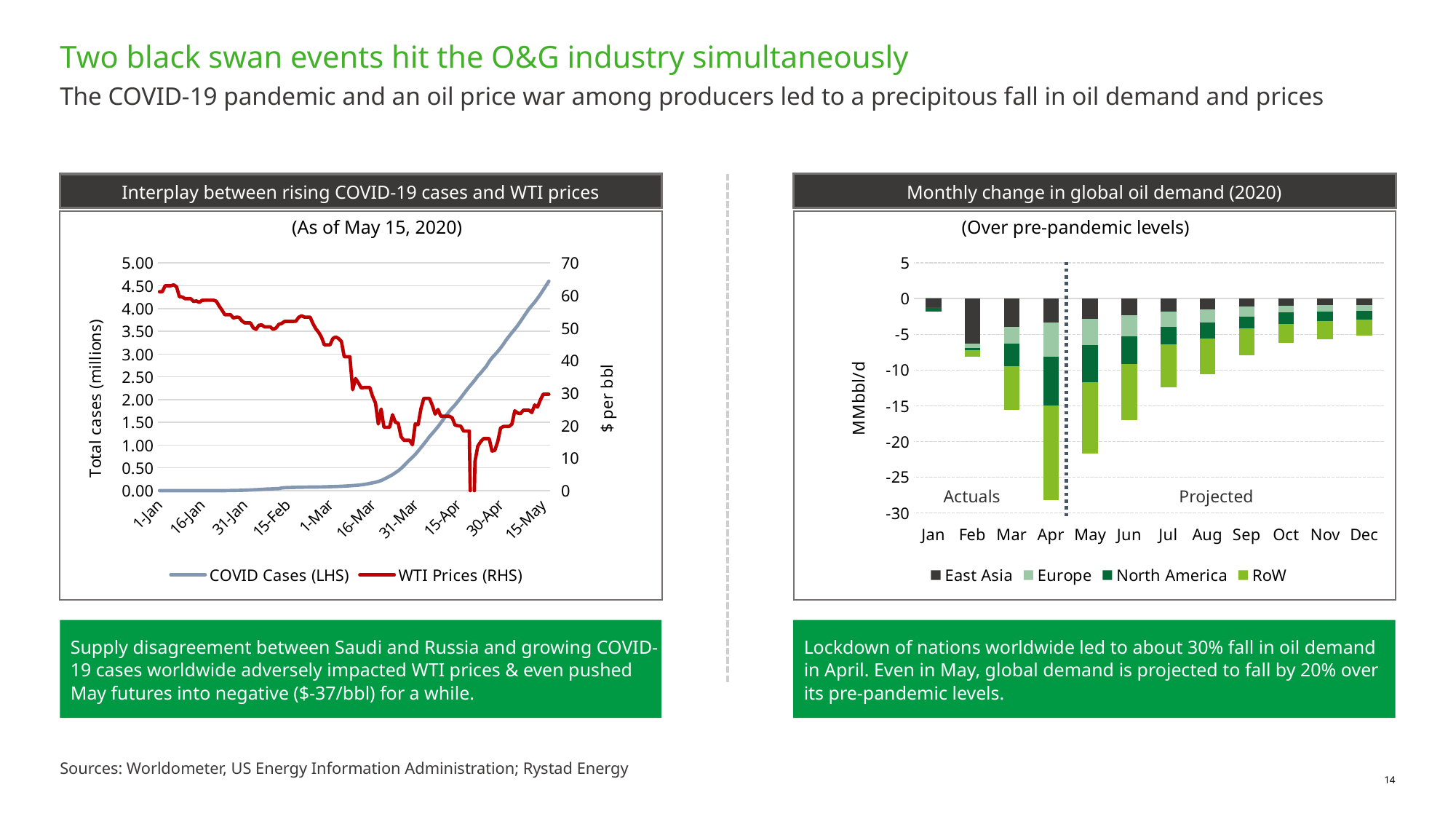
How many series does the legend of 'Monthly change in global oil demand (2020)' list? 4 In 'Monthly change in global oil demand (2020)', which region is shown in the lightest green colour in the legend? Europe In 'Monthly change in global oil demand (2020)', is the total change for Apr greater or less than -25 MMbbl/d? less What kind of chart is 'Monthly change in global oil demand (2020)'? stacked bar chart What kind of chart is 'Interplay between rising COVID-19 cases and WTI prices'? line chart In 'Monthly change in global oil demand (2020)', which month shows the largest fall in oil demand? Apr In 'Interplay between rising COVID-19 cases and WTI prices', do COVID cases rise or fall from 1-Jan to 15-May? rise In 'Interplay between rising COVID-19 cases and WTI prices', is the WTI price at 1-Jan greater or less than 50 $ per bbl? greater In 'Monthly change in global oil demand (2020)', which month has the larger fall in demand, Apr or May? Apr How many months are shown on the x axis of 'Monthly change in global oil demand (2020)'? 12 How many series does the legend of 'Interplay between rising COVID-19 cases and WTI prices' list? 2 In 'Interplay between rising COVID-19 cases and WTI prices', is the COVID cases value at 15-May greater or less than 4.00 million? greater